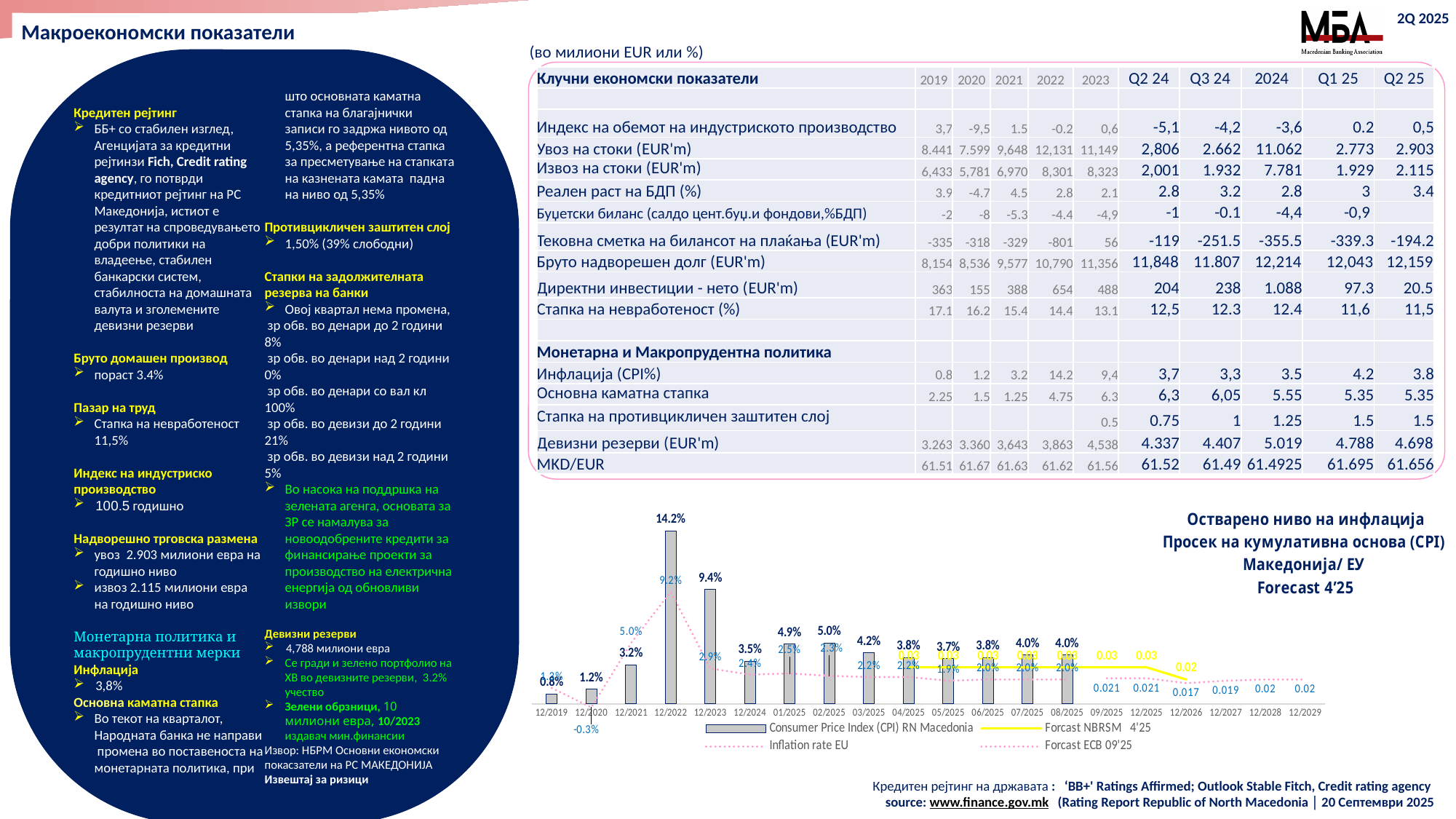
What kind of chart is shown at the bottom of the slide? A combination bar and line chart In the inflation chart, what is the CPI RN Macedonia value for 08/2025? 4.0% In the inflation chart, which period has the highest CPI RN Macedonia bar? 12/2022 In the inflation chart, which period has the lowest CPI RN Macedonia bar? 12/2019 In the inflation chart, which is larger, the CPI RN Macedonia value for 01/2025 or for 02/2025? 02/2025 In the inflation chart, do the CPI RN Macedonia bars rise or fall from 12/2022 to 12/2024? Fall In the inflation chart, what is the Inflation rate EU value for 12/2022? 9.2% In the inflation chart, what is the Inflation rate EU value for 12/2020? -0.3% How many series does the legend of the inflation chart list? 4 In the inflation chart, what is the Consumer Price Index (CPI) RN Macedonia value for 12/2022? 14.2% In the inflation chart, what is the difference between the CPI RN Macedonia values for 12/2022 and 12/2023? 4.8 percentage points How many CPI RN Macedonia bars are plotted in the inflation chart? 14